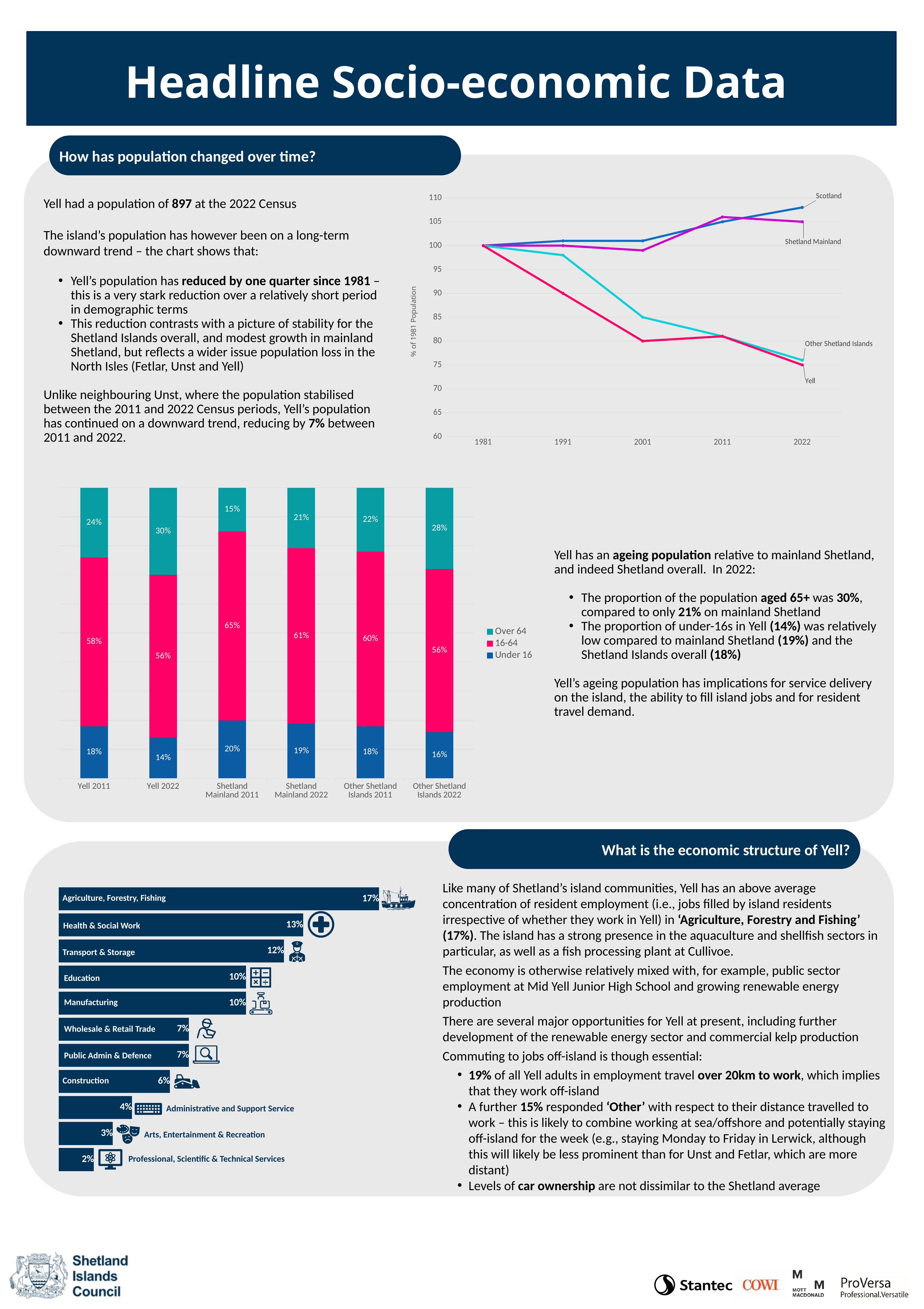
In the stacked bar chart of age structure, what is the difference between the Over 64 share for Yell 2022 and Shetland Mainland 2022? 9% In the stacked bar chart of age structure, what percentage of Yell's 2022 population was aged 16-64? 56% In the stacked bar chart of age structure, which category has the highest Over 64 share? Yell 2022 In the horizontal bar chart of economic structure, how many sectors are shown? 11 In the stacked bar chart of age structure, how many series does the legend list? 3 In the horizontal bar chart of economic structure, which sector has the highest share? Agriculture, Forestry, Fishing In the stacked bar chart of age structure, what is the Under 16 share for Shetland Mainland 2011? 20% In the horizontal bar chart of economic structure, what is the value for Health & Social Work? 13% In the line chart of population as % of 1981, is the value for Yell in 2022 greater or less than 80? less In the horizontal bar chart of economic structure, which is larger: Transport & Storage or Construction? Transport & Storage In the stacked bar chart of age structure, which category has the lowest Under 16 share? Yell 2022 In the line chart of population as % of 1981, does the Yell line rise or fall from 1981 to 2022? fall